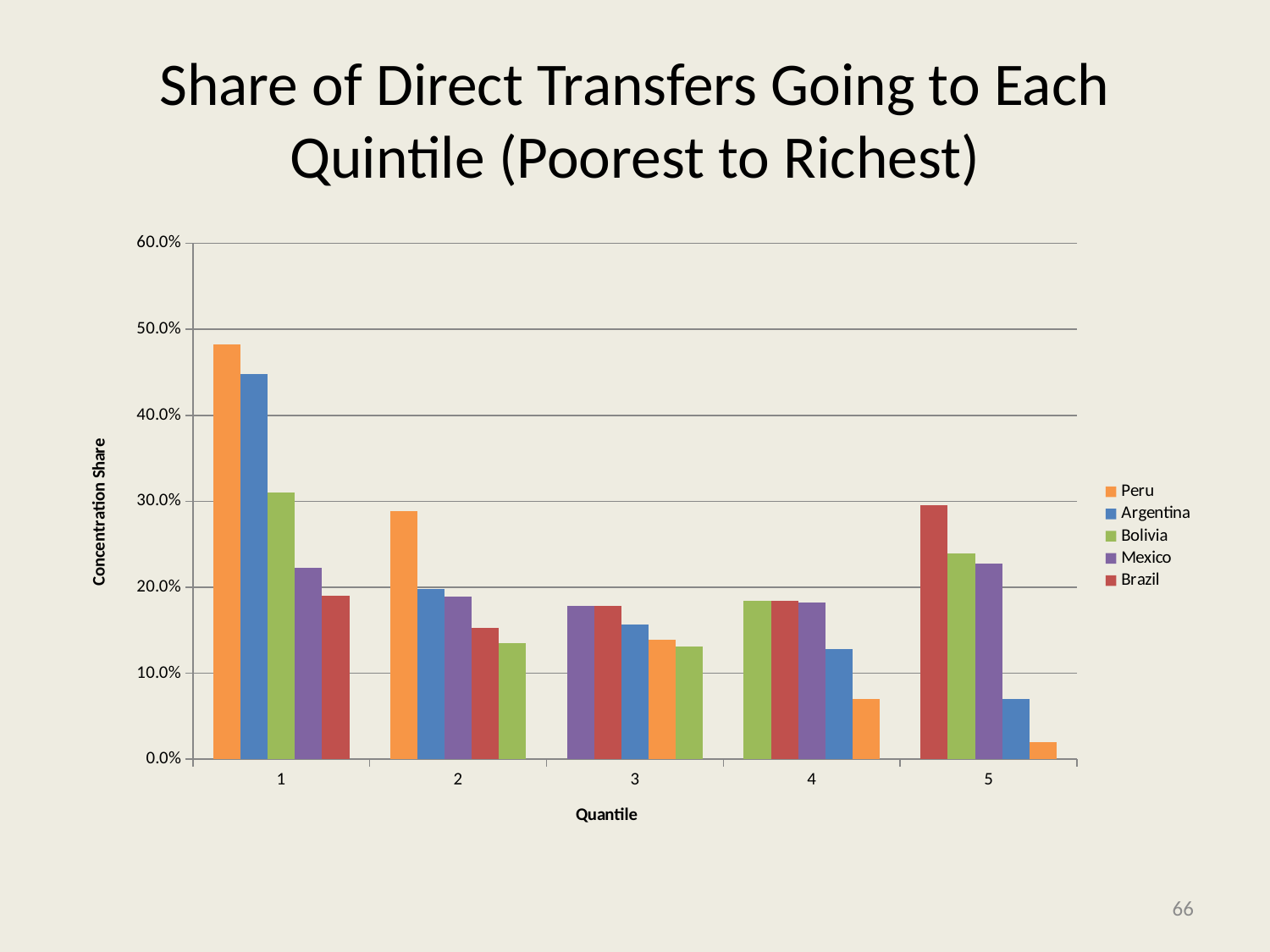
What kind of chart is shown on the slide? bar chart Which country has the lowest concentration share in quintile 5? Peru Do the values for Peru rise or fall from quintile 1 to quintile 5? fall Is the value for Brazil in quintile 1 greater or less than 20.0%? less Is the value for Peru in quintile 5 greater or less than 10.0%? less What is the label on the vertical axis? Concentration Share Which country has the highest concentration share in quintile 1? Peru How many series does the legend list? 5 Which country has the highest concentration share in quintile 5? Brazil In quintile 2, which is larger: the value for Peru or the value for Bolivia? Peru How many quintile categories are shown on the x axis? 5 Is the value for Peru in quintile 1 greater or less than 40.0%? greater